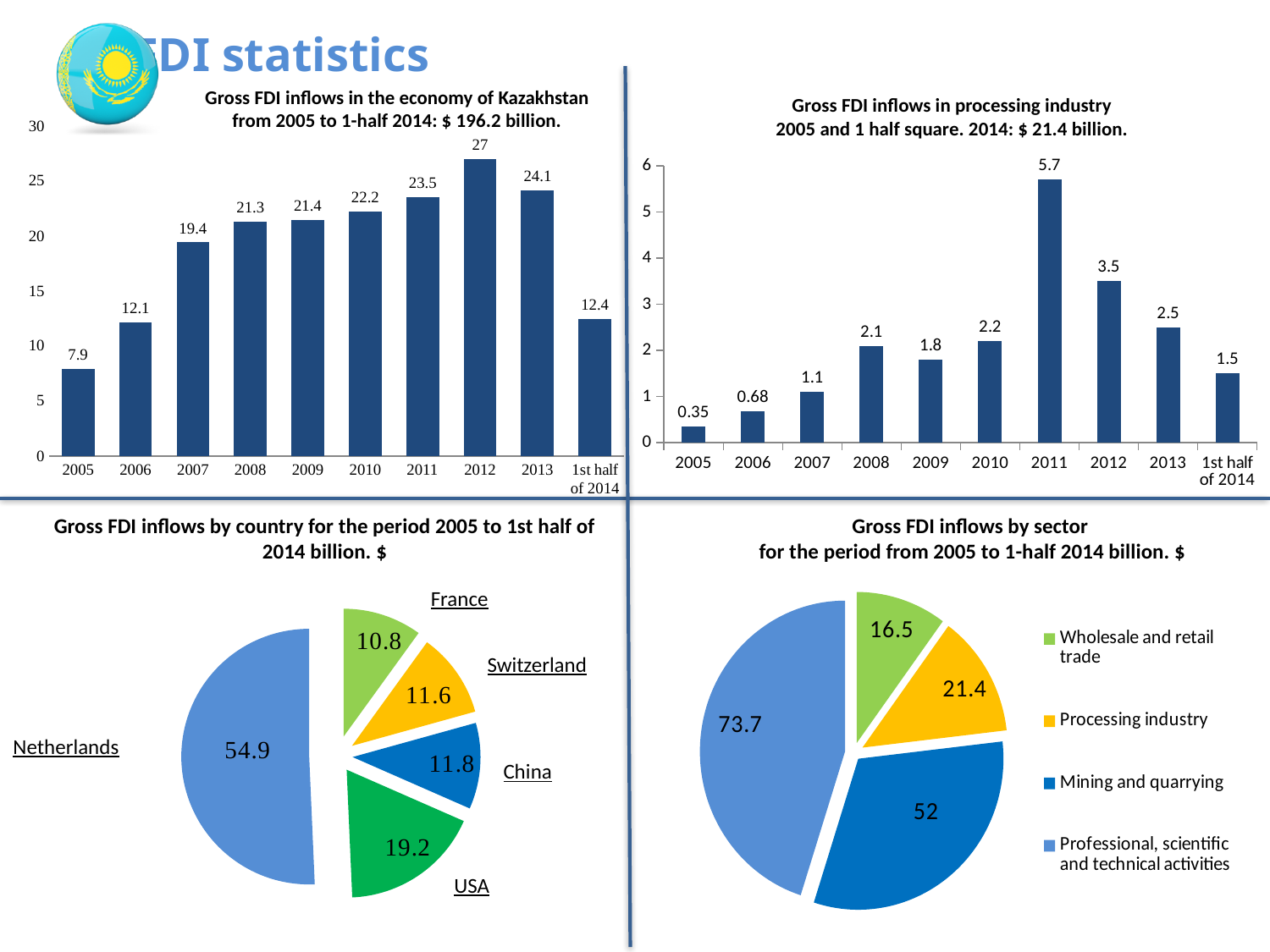
In the chart 'Gross FDI inflows in the economy of Kazakhstan', what is the difference between the values for 2012 and 2013? 2.9 In the pie chart 'Gross FDI inflows by sector', what is the value for Mining and quarrying? 52 In the chart 'Gross FDI inflows in processing industry', which year has the highest value? 2011 In the chart 'Gross FDI inflows in the economy of Kazakhstan', which year has the lowest value? 2005 What kind of chart is 'Gross FDI inflows in processing industry'? Bar chart How many entries does the legend of the chart 'Gross FDI inflows by sector' list? 4 In the pie chart 'Gross FDI inflows by country', which country has the largest slice? Netherlands In the chart 'Gross FDI inflows in the economy of Kazakhstan', what is the value for 2012? 27 In the chart 'Gross FDI inflows in the economy of Kazakhstan', how many categories are shown on the x axis? 10 In the pie chart 'Gross FDI inflows by country', what is the value for USA? 19.2 In the chart 'Gross FDI inflows in processing industry', what is the value for 2006? 0.68 In the chart 'Gross FDI inflows in processing industry', which is larger, the value for 2009 or the value for 2010? 2010